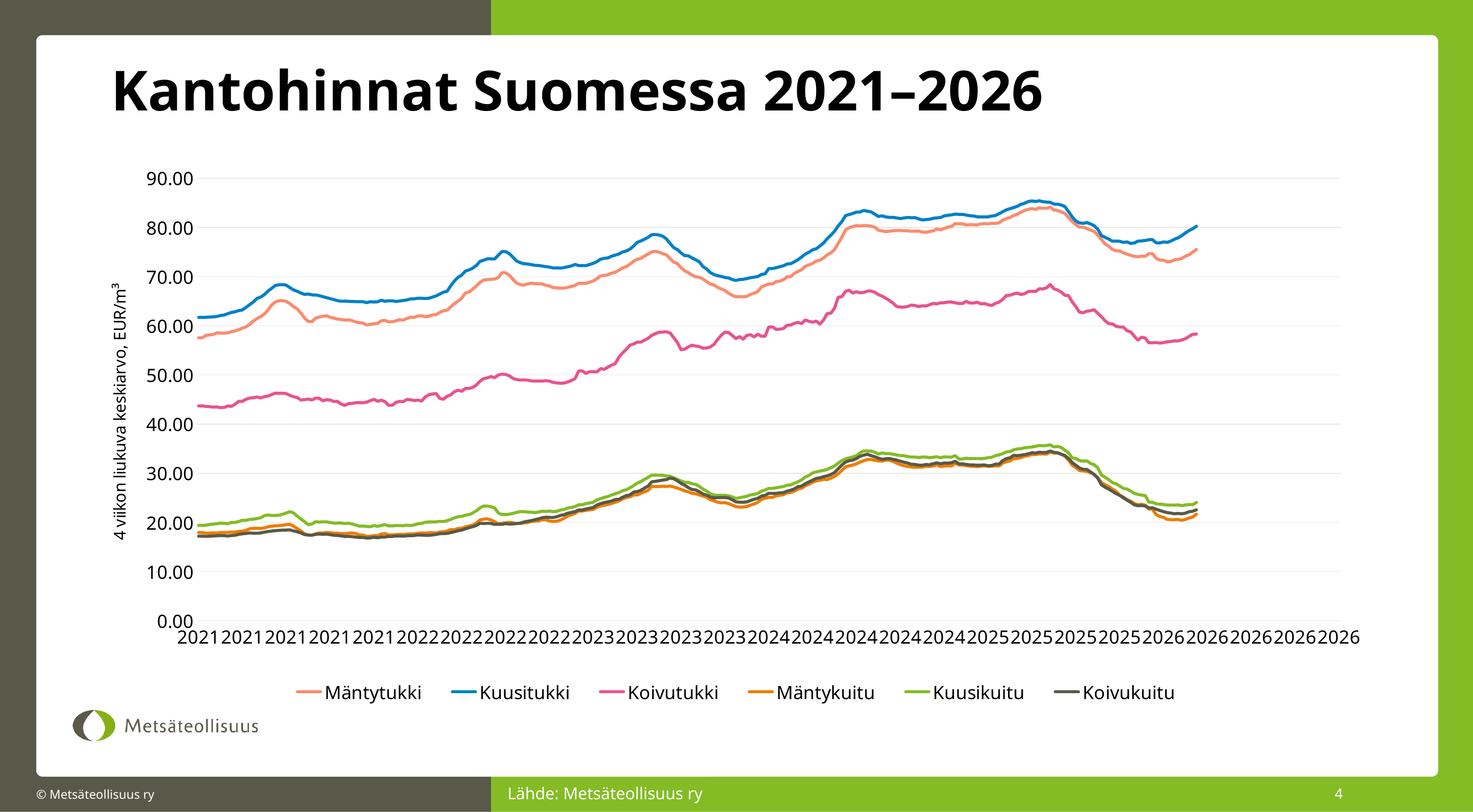
Is the peak value for Kuusitukki greater or less than 80.00? greater What is the label of the vertical axis? 4 viikon liukuva keskiarvo, EUR/m³ Is the peak value for Kuusikuitu greater or less than 40.00? less Which is higher across the chart, Koivutukki or Kuusikuitu? Koivutukki Which is higher across the chart, Kuusitukki or Mäntytukki? Kuusitukki What kind of chart is shown on the slide? Line chart How many series does the legend list? 6 In which year does the Kuusitukki series reach its highest value? 2025 Which series has the highest values throughout the chart? Kuusitukki Is the value for Koivutukki at the start of 2021 greater or less than 50.00? less Does the Koivutukki series overall rise or fall from 2021 to 2026? rise What is the title of the chart on the slide? Kantohinnat Suomessa 2021–2026